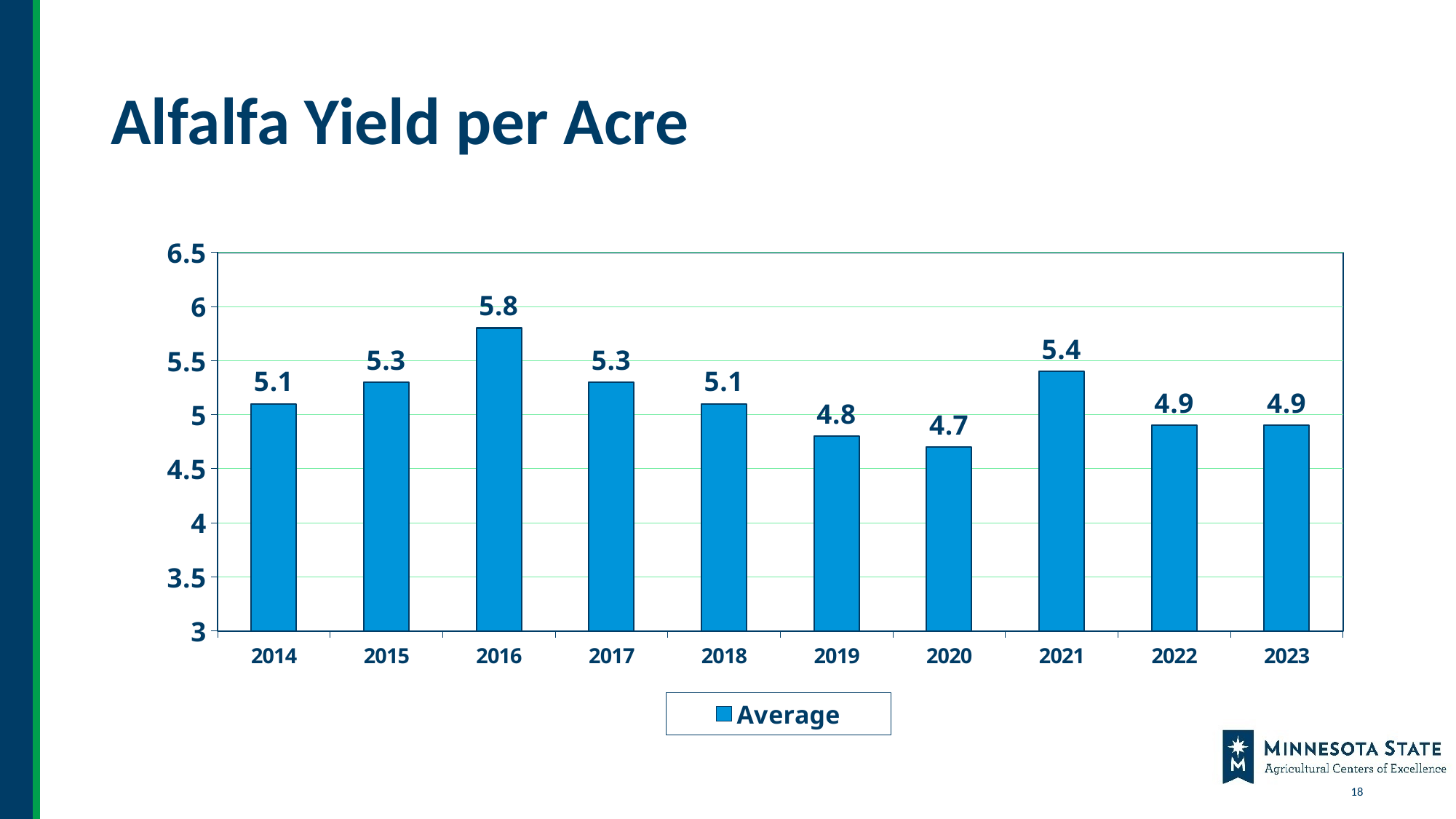
What is the name of the series shown in the legend? Average Which year has the highest alfalfa yield per acre? 2016 Is the alfalfa yield per acre for 2021 greater or less than 5? greater How many series does the legend list? 1 Which year has a higher alfalfa yield per acre, 2015 or 2019? 2015 What is the alfalfa yield per acre for 2021? 5.4 How many years are shown on the x axis of the chart? 10 What is the difference between the alfalfa yield per acre in 2016 and in 2020? 1.1 What is the alfalfa yield per acre for 2016? 5.8 Which year has the lowest alfalfa yield per acre? 2020 What kind of chart is shown on the slide? Bar chart What is the alfalfa yield per acre for 2020? 4.7